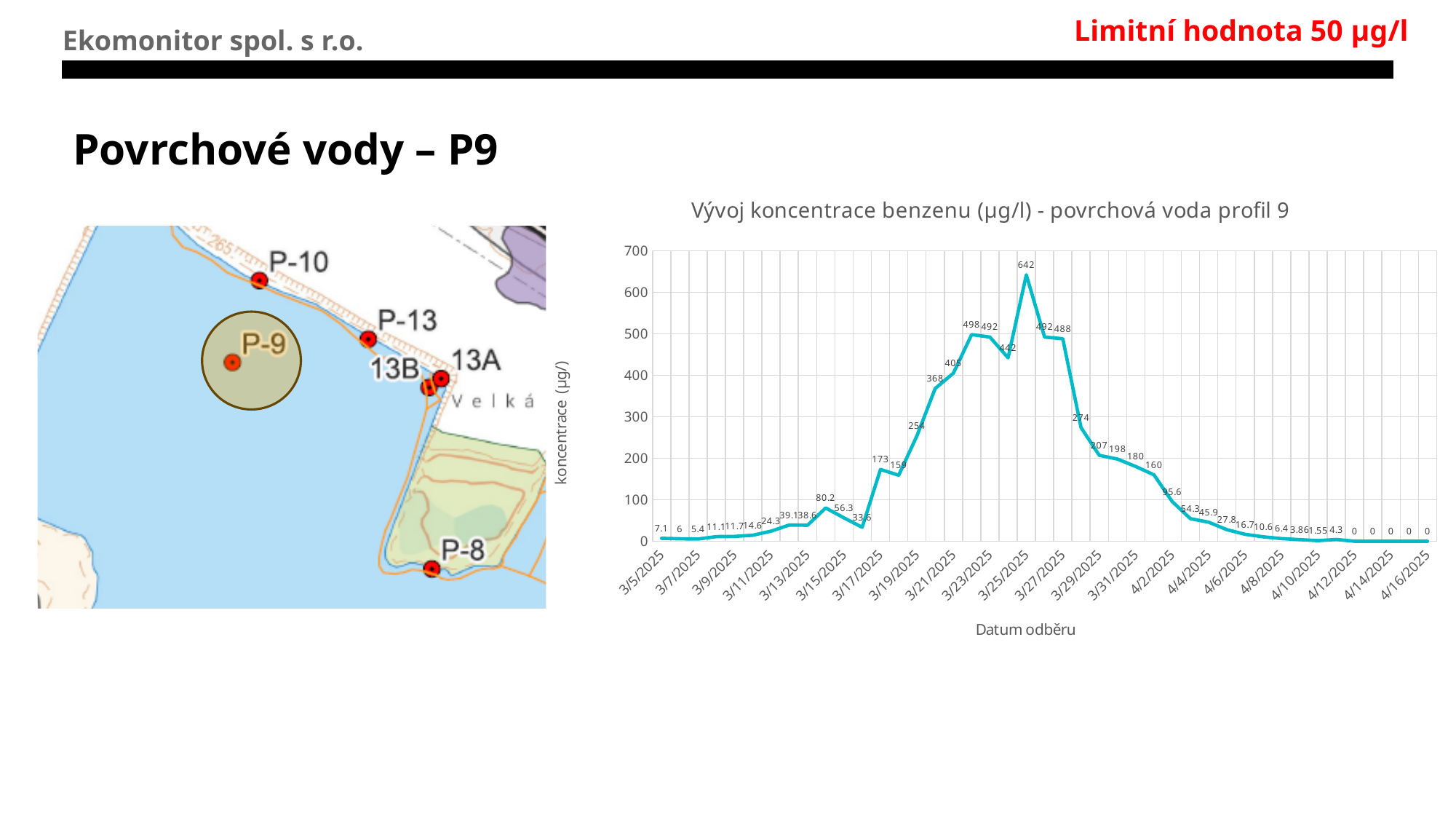
Is the value for 3/19/2025 greater or less than 200? greater What is the value plotted for 3/17/2025? 173 What is the value plotted for 4/2/2025? 95.6 Do the values rise or fall along the x axis from 3/25/2025 to 4/16/2025? fall What is the benzene concentration value plotted for 3/25/2025? 642 What kind of chart is shown on the slide? line chart What is the title of the chart? Vývoj koncentrace benzenu (µg/l) - povrchová voda profil 9 What is the value plotted for 3/5/2025? 7.1 Which is larger, the value on 3/17/2025 or the value on 3/19/2025? 3/19/2025 What is the difference between the value on 3/25/2025 (642) and the value on 3/27/2025 (488)? 154 What is the label of the x axis of the chart? Datum odběru On which date does the concentration reach its highest value? 3/25/2025